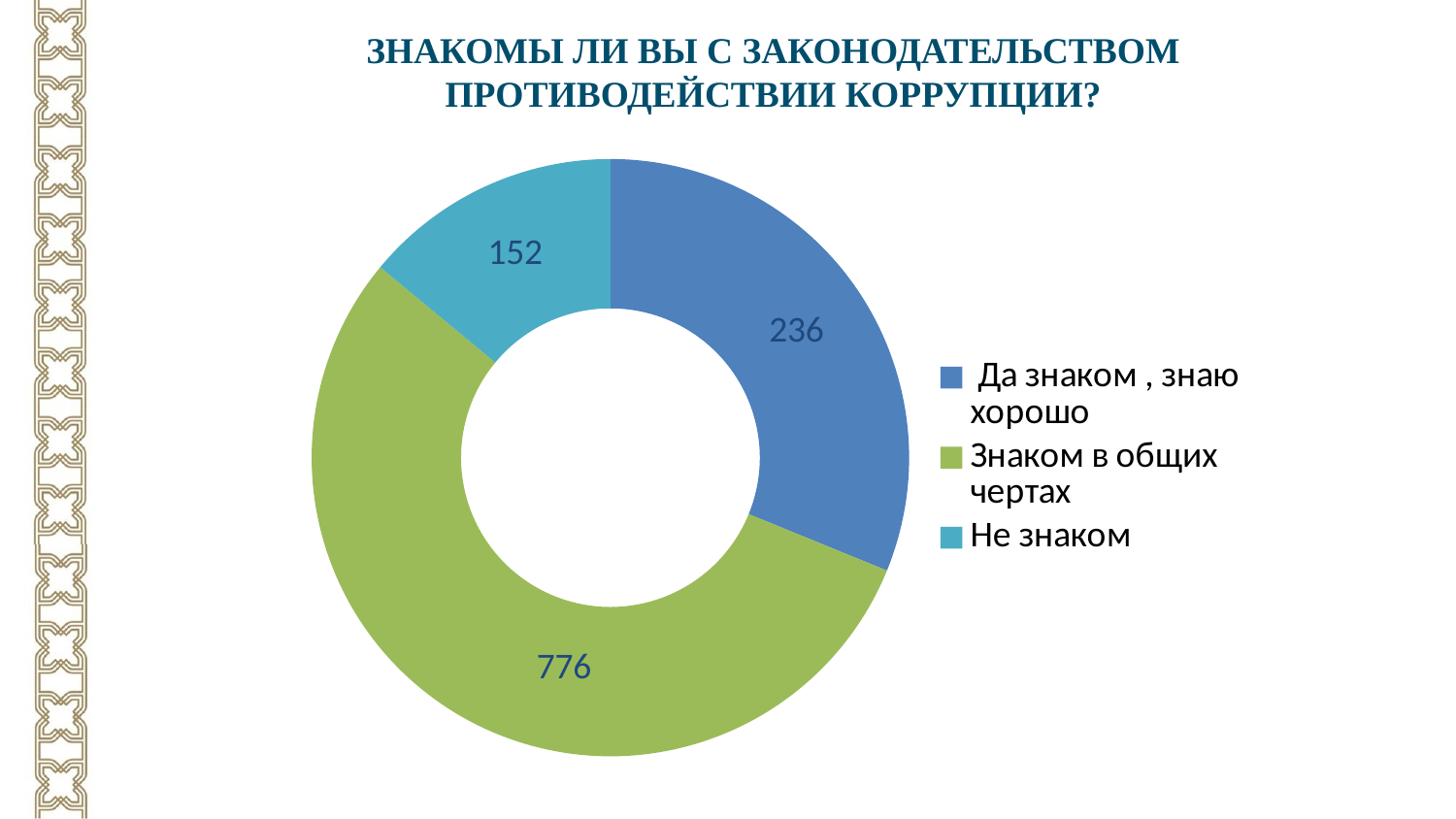
How many categories does the chart show? 3 Which is larger: the value for "Да знаком, знаю хорошо" or the value for "Не знаком"? Да знаком, знаю хорошо What is the difference between the values for "Знаком в общих чертах" and "Да знаком, знаю хорошо"? 540 Which category has the lowest value? Не знаком What value is shown for the category "Да знаком, знаю хорошо"? 236 What is the total of all three values shown in the chart? 1164 What kind of chart is shown on the slide? doughnut chart What value is shown for the category "Знаком в общих чертах"? 776 What value is shown for the category "Не знаком"? 152 Which colour represents the category "Не знаком" in the chart? teal (light blue) What is the difference between the values for "Да знаком, знаю хорошо" and "Не знаком"? 84 Which category has the highest value? Знаком в общих чертах